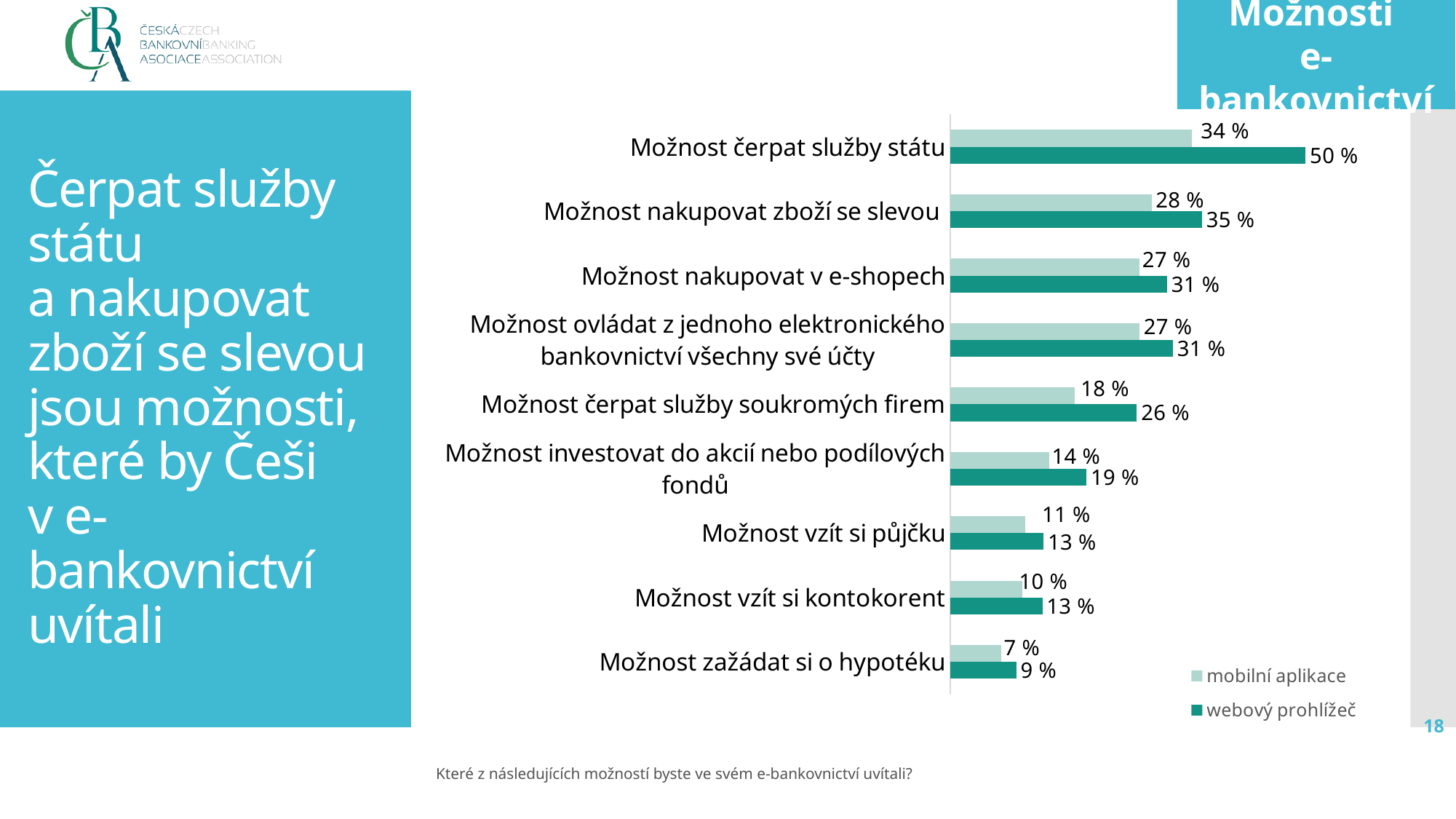
What is the value for 'Možnost čerpat služby státu' in the 'webový prohlížeč' series? 50 % Which is larger for 'Možnost čerpat služby soukromých firem': the 'mobilní aplikace' value or the 'webový prohlížeč' value? webový prohlížeč What is the value for 'Možnost nakupovat zboží se slevou' in the 'mobilní aplikace' series? 28 % What is the value for 'Možnost zažádat si o hypotéku' in the 'webový prohlížeč' series? 9 % How many categories are shown in the chart? 9 What is the value for 'Možnost vzít si kontokorent' in the 'mobilní aplikace' series? 10 % What are the two series listed in the chart legend? mobilní aplikace, webový prohlížeč How many series does the legend list? 2 What kind of chart is shown on the slide? bar chart Which category has the lowest value in the 'mobilní aplikace' series? Možnost zažádat si o hypotéku What is the difference between the 'webový prohlížeč' and 'mobilní aplikace' values for 'Možnost čerpat služby státu'? 16 % Which category has the highest value in the 'webový prohlížeč' series? Možnost čerpat služby státu